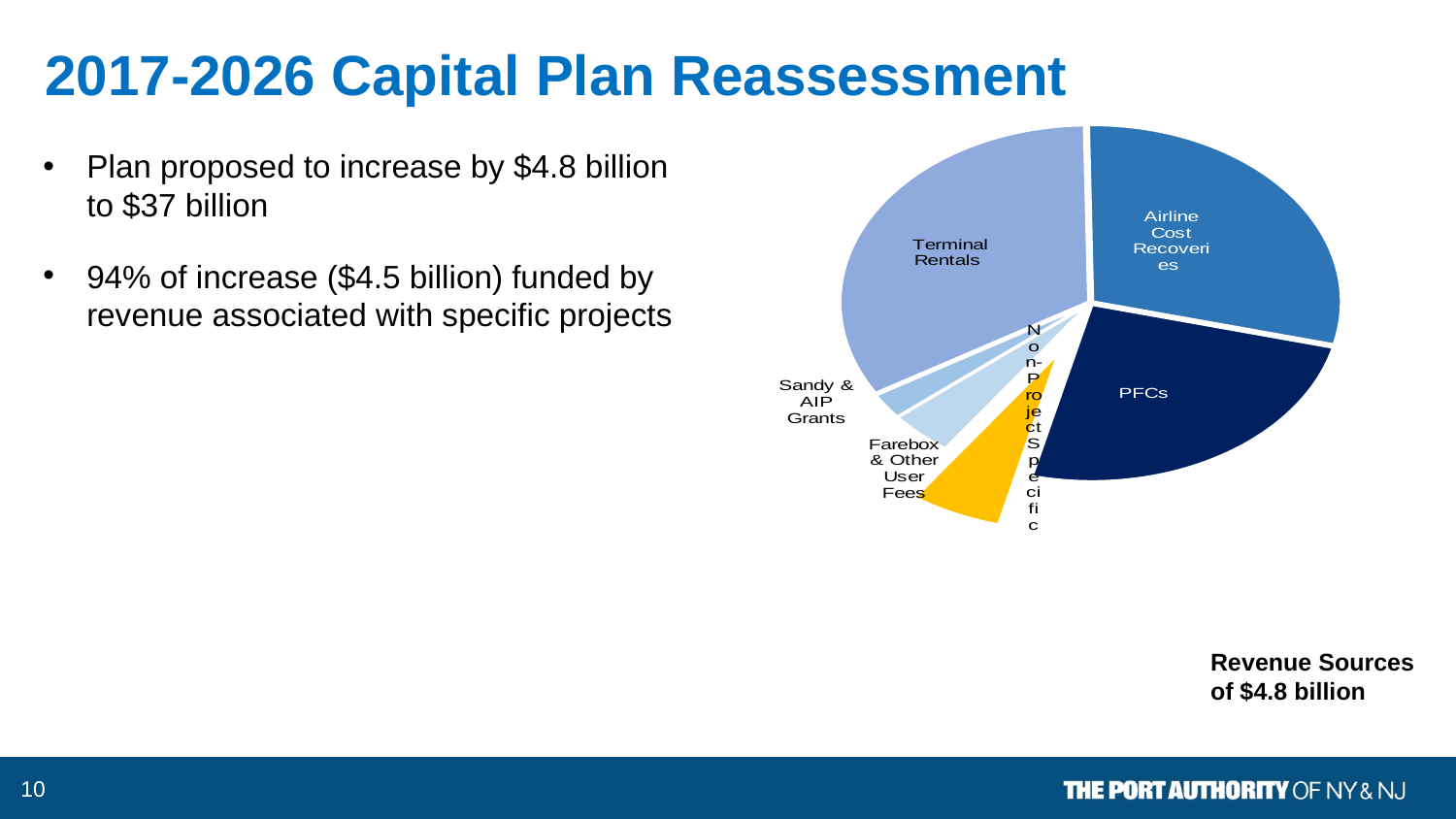
Which revenue source is the largest slice of the pie chart? Terminal Rentals What kind of chart is shown on the slide? pie chart Which slice of the pie chart is coloured yellow? Non-Project Specific Which is larger in the pie chart, Airline Cost Recoveries or Sandy & AIP Grants? Airline Cost Recoveries How many slices does the pie chart have? 6 Which is larger in the pie chart, Terminal Rentals or PFCs? Terminal Rentals Which is larger in the pie chart, PFCs or Farebox & Other User Fees? PFCs According to the caption, what total amount do the revenue sources in the pie chart add up to? $4.8 billion